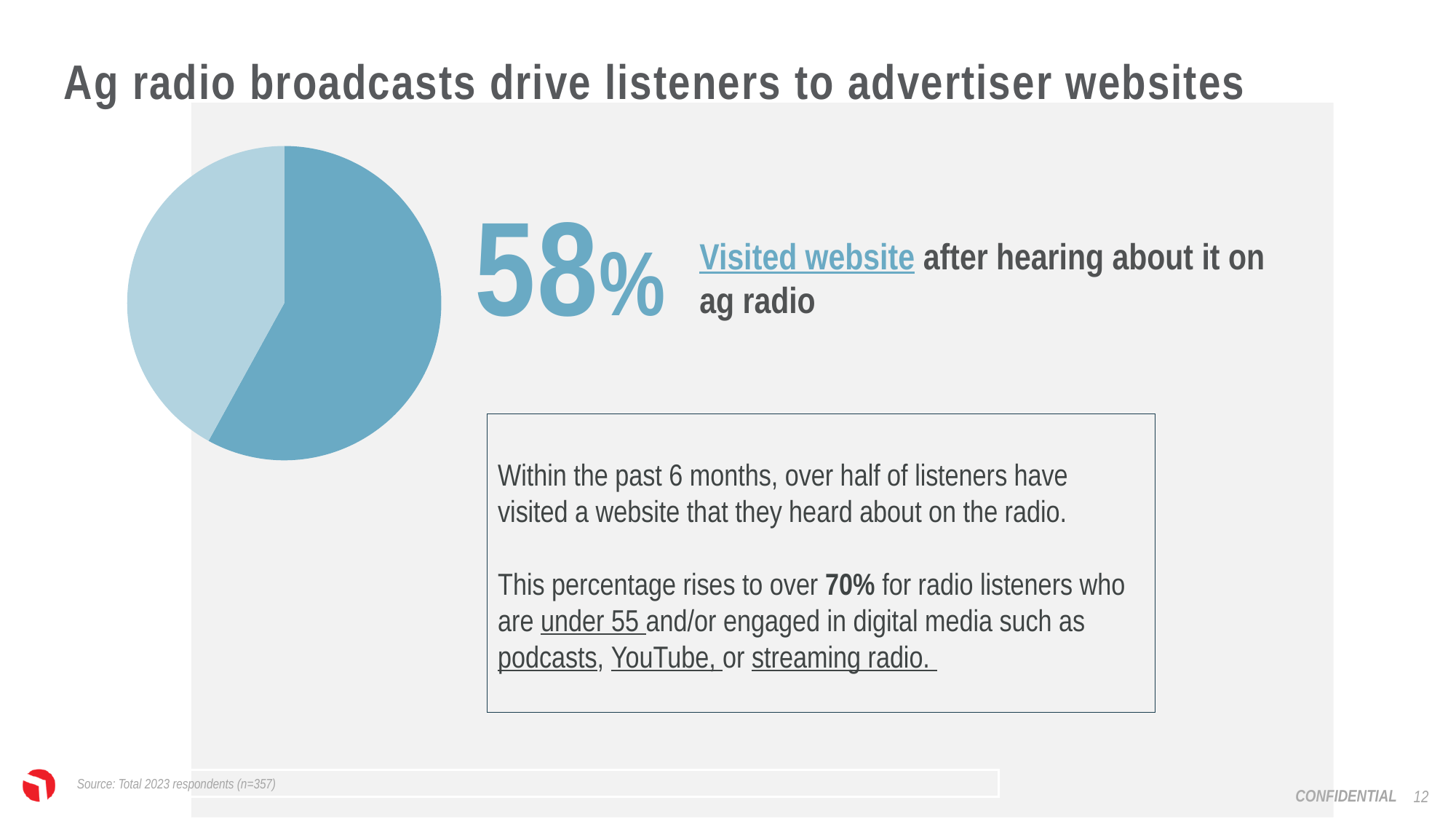
Which category makes up the largest slice of the pie chart? Visited website after hearing about it on ag radio Is the lighter blue slice of the pie greater or less than 50% of the pie? less What percentage of listeners visited a website after hearing about it on ag radio? 58% How many slices does the pie chart have? 2 Which slice of the pie chart is larger, the darker blue slice or the lighter blue slice? The darker blue slice Is the share of listeners who visited a website after hearing about it on ag radio greater or less than 50%? greater What share of the pie does the darker blue slice (visited website) represent? 58% According to the source note, how many respondents does the chart data come from? n=357 What is the title of the slide containing the pie chart? Ag radio broadcasts drive listeners to advertiser websites What kind of chart is shown on the slide? Pie chart